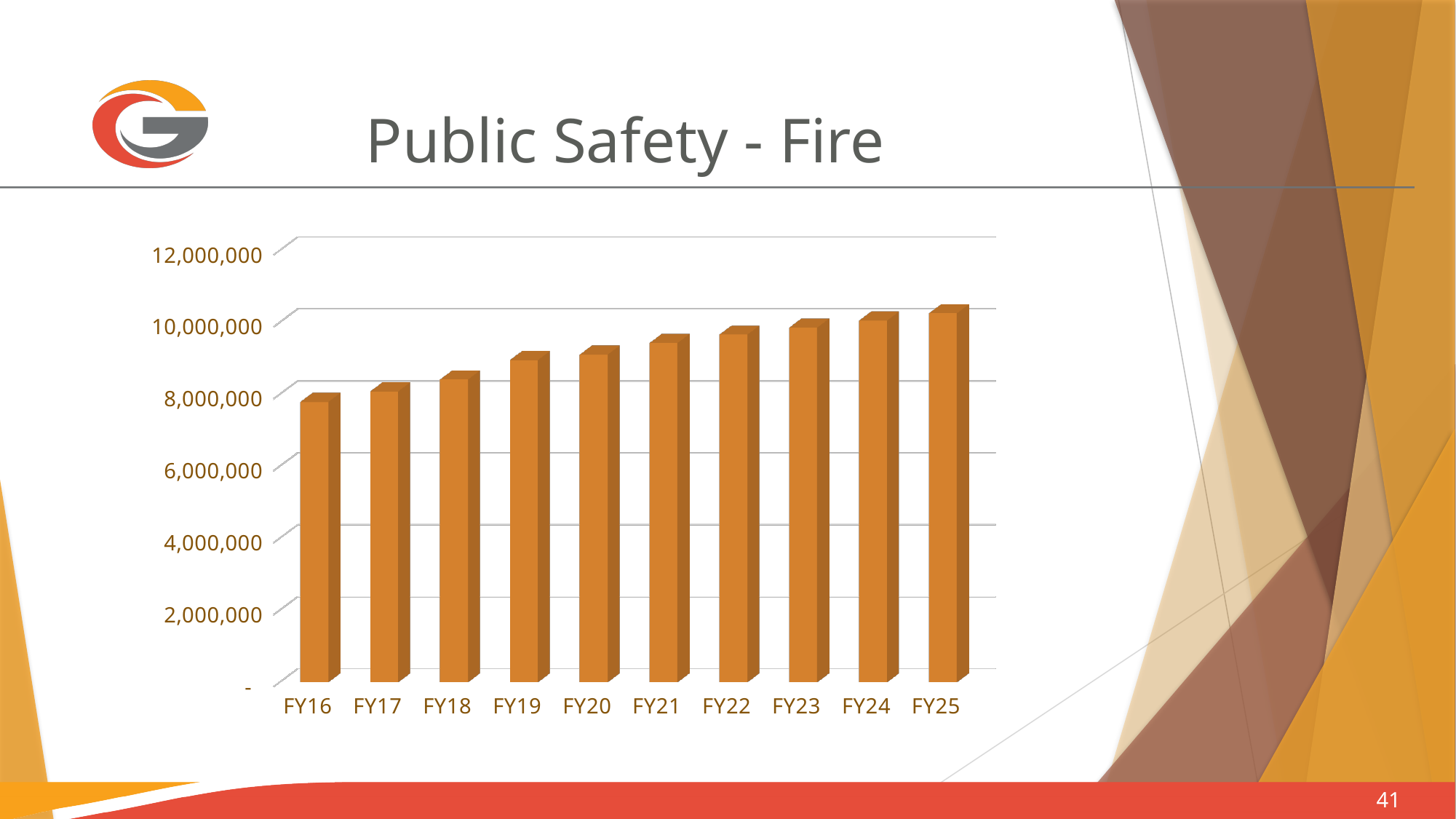
Is the value for FY18 greater or less than 8,000,000? greater Is the value for FY19 greater or less than 10,000,000? less How many fiscal years are plotted on the x axis? 10 What is the title of the slide containing the chart? Public Safety - Fire Which fiscal year has the lowest value? FY16 What kind of chart is shown on the slide? bar chart Do the values rise or fall from FY16 to FY25? rise Which is larger, the value for FY16 or the value for FY25? FY25 Is the value for FY20 greater or less than 6,000,000? greater Which fiscal year has the highest value? FY25